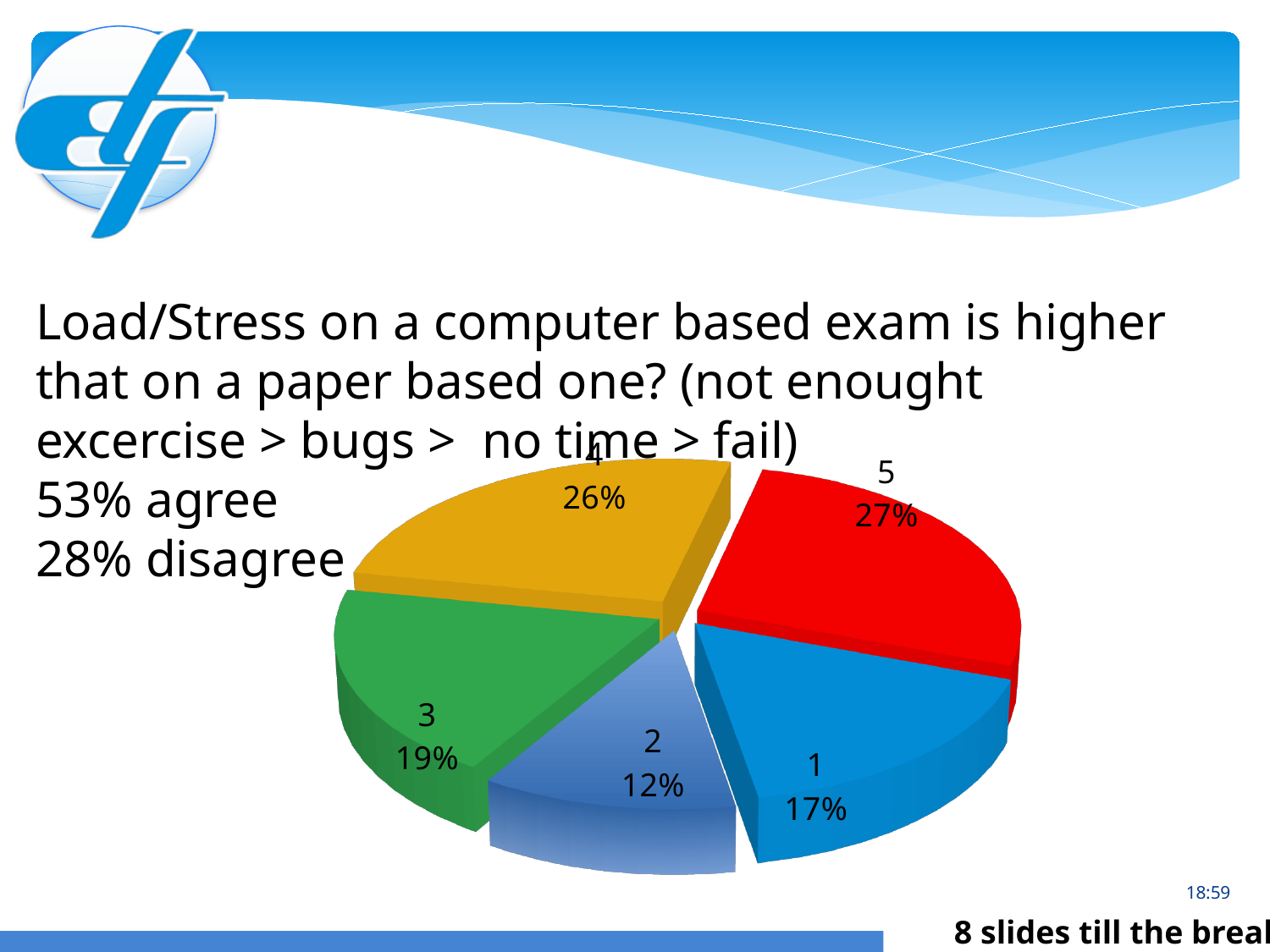
What kind of chart is shown on the slide? pie chart Which slice has the smallest share of the pie? 2 What percentage is shown for slice 4? 26% What percentage is shown for slice 5? 27% What is the combined share of slices 4 and 5? 53% What percentage is shown for slice 1? 17% What percentage is shown for slice 3? 19% Which is larger, the share for slice 3 or the share for slice 1? 3 What colour is the slice labelled 3? green What is the difference in percentage points between slice 4 and slice 2? 14 How many slices does the pie chart have? 5 What percentage is shown for slice 2? 12%